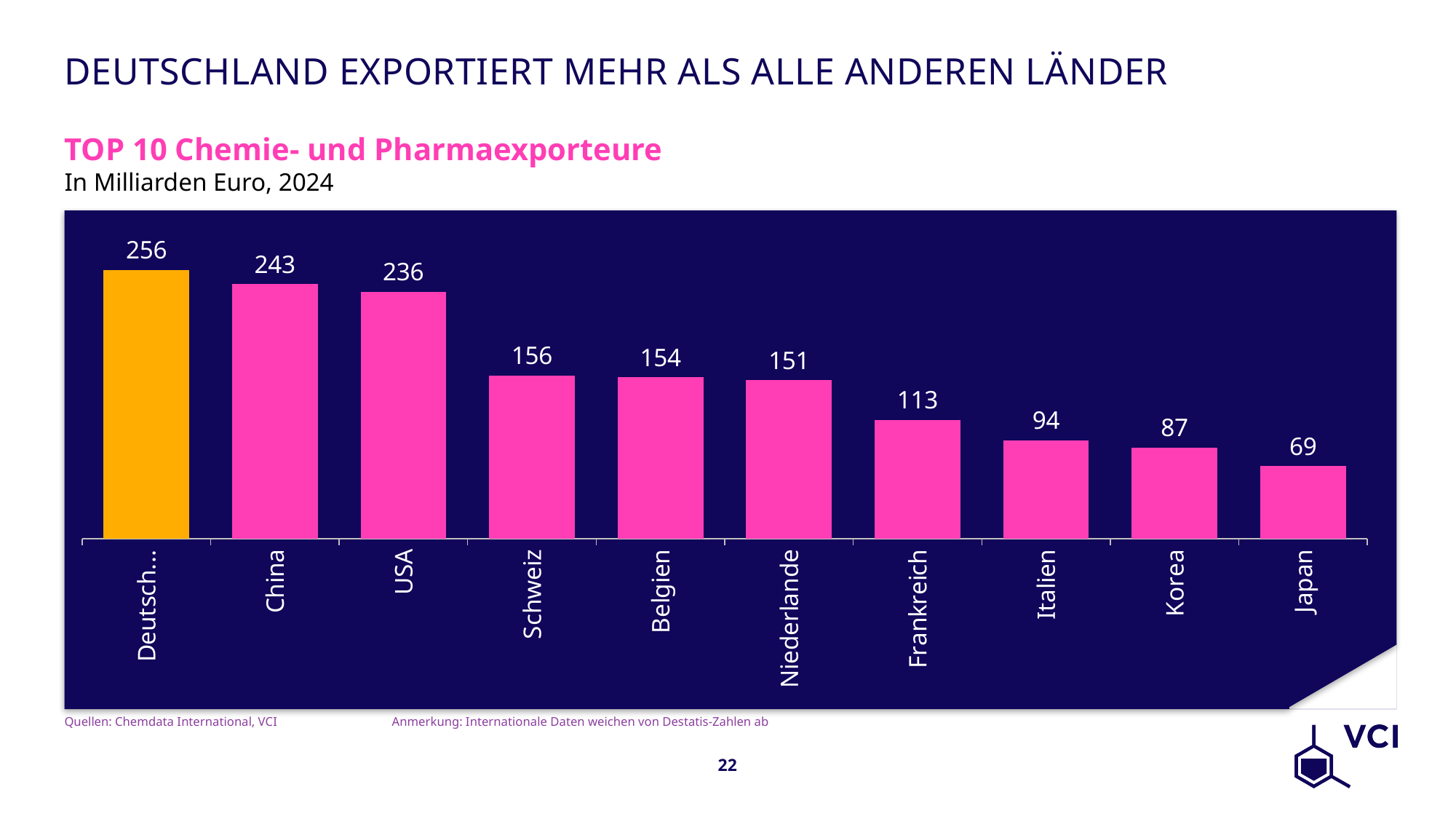
Which bar is coloured differently (orange) from the others? Deutschland What kind of chart is shown on the slide? Bar chart Which country has the highest value? Deutschland Which is larger, the value for Italien or the value for Korea? Italien How many countries are shown in the chart? 10 What is the value for Japan? 69 What is the value for Frankreich? 113 What is the value for Schweiz? 156 What is the value for China? 243 What is the difference between the values for China and USA? 7 What is the difference between the values for Deutschland and Japan? 187 Which country has the lowest value? Japan